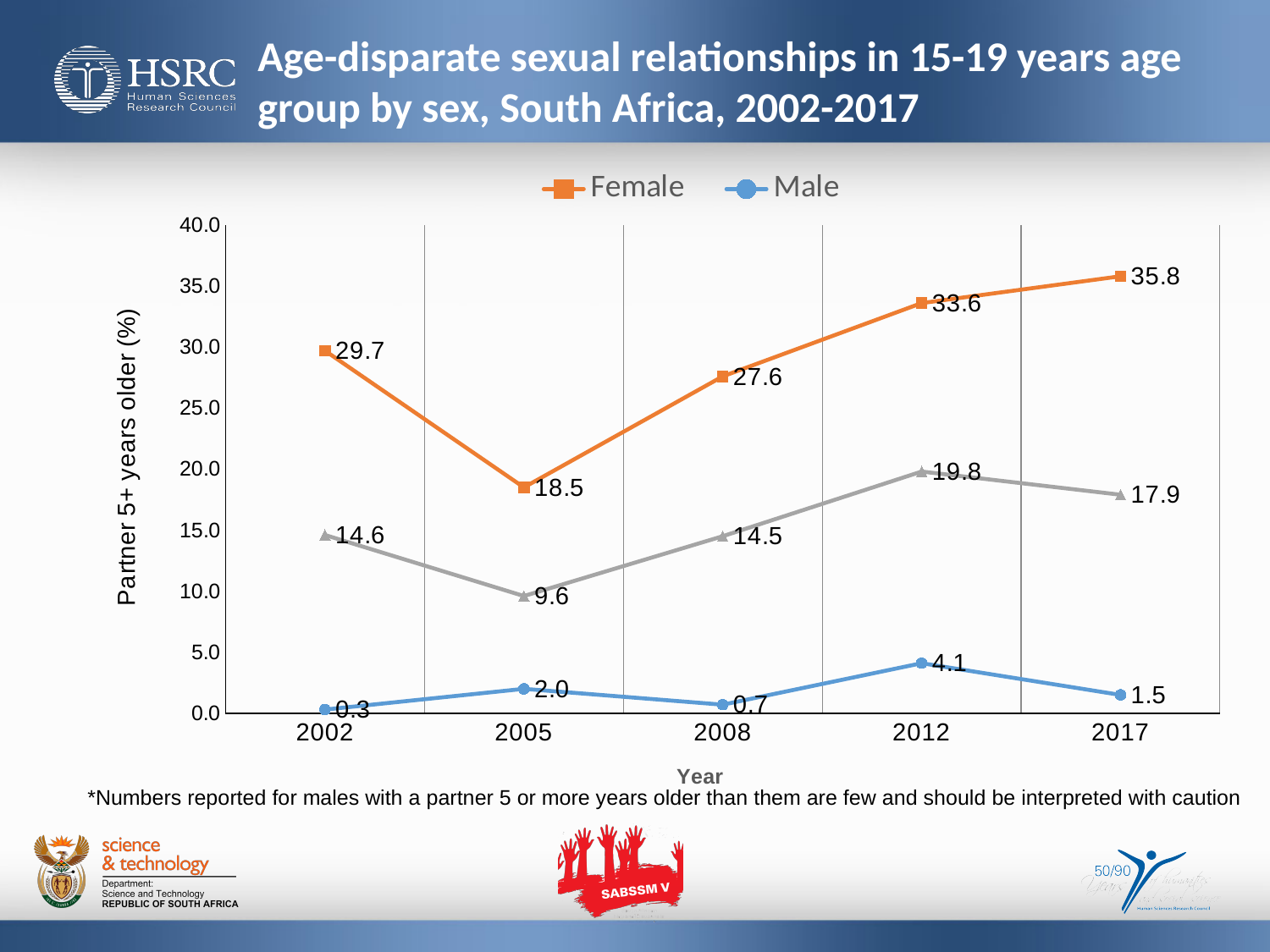
In which year is the Male value highest? 2012 How many series does the legend list? 2 Which is larger, the Female value for 2008 or the Female value for 2002? 2002 What is the Female value for 2017? 35.8 Is the Female value for 2012 greater or less than 30.0? greater How many years are shown on the x axis? 5 What is the Male value for 2012? 4.1 In which year is the Female value lowest? 2005 What kind of chart is shown on the slide? line chart What is the label of the y axis? Partner 5+ years older (%) What is the Female value for 2005? 18.5 What is the difference between the Female values for 2017 and 2002? 6.1